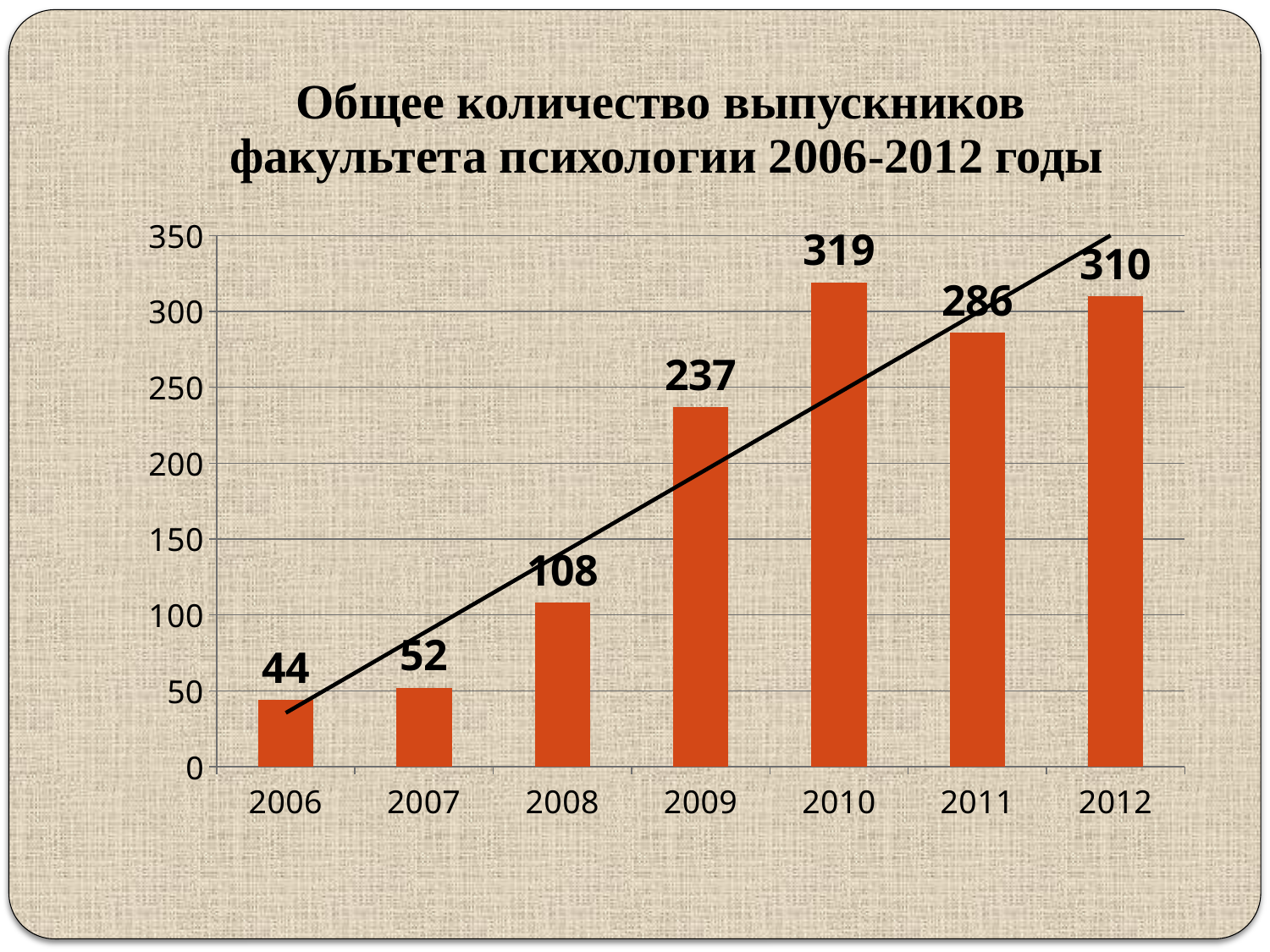
What kind of chart is this? bar chart What is the value for 2006? 44 Which year has the lowest value? 2006 How many years are shown on the x axis? 7 What is the difference between the values for 2008 and 2007? 56 Which year has the highest value? 2010 What is the value for 2011? 286 Do the values generally rise or fall from 2006 to 2010? rise What is the difference between the values for 2010 and 2012? 9 What is the value for 2009? 237 Which is larger, the value for 2011 or the value for 2012? 2012 Is the value for 2009 greater or less than 200? greater